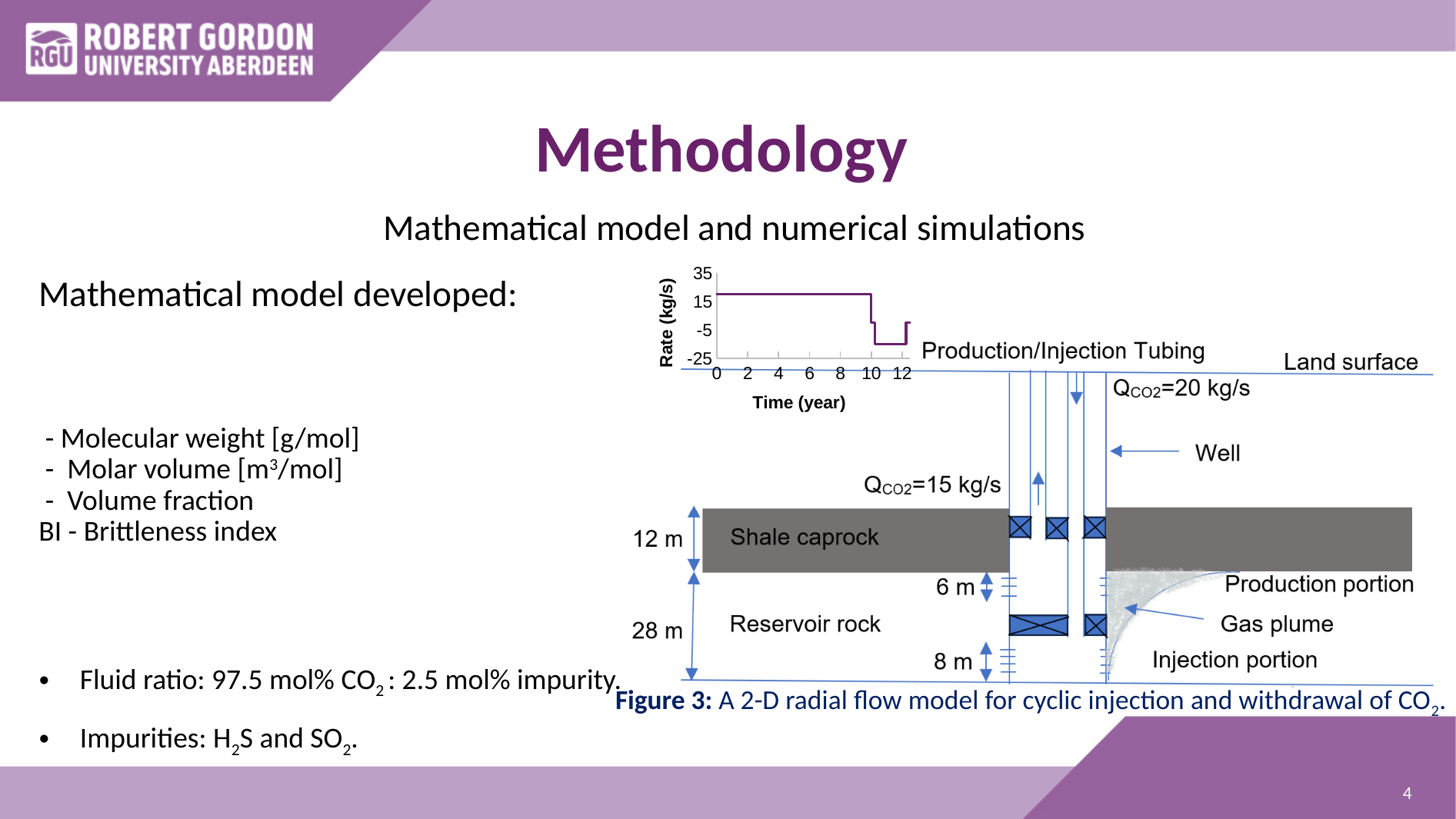
What is the label of the horizontal axis of the line chart? Time (year) In the line chart, is the rate at year 11 greater or less than -25? greater What kind of chart is shown on the slide next to the text 'Mathematical model developed'? line chart What is the highest value labelled on the vertical axis of the line chart? 35 How many tick marks are labelled on the horizontal (Time) axis of the line chart? 7 In the line chart, is the rate at year 11 greater or less than -5? less In the line chart, is the rate at year 8 greater or less than -5? greater Is the rate in the line chart higher at year 4 or at year 11? year 4 Does the rate in the line chart rise or fall as time goes from year 0 to year 12? fall What is the label of the vertical axis of the line chart? Rate (kg/s)